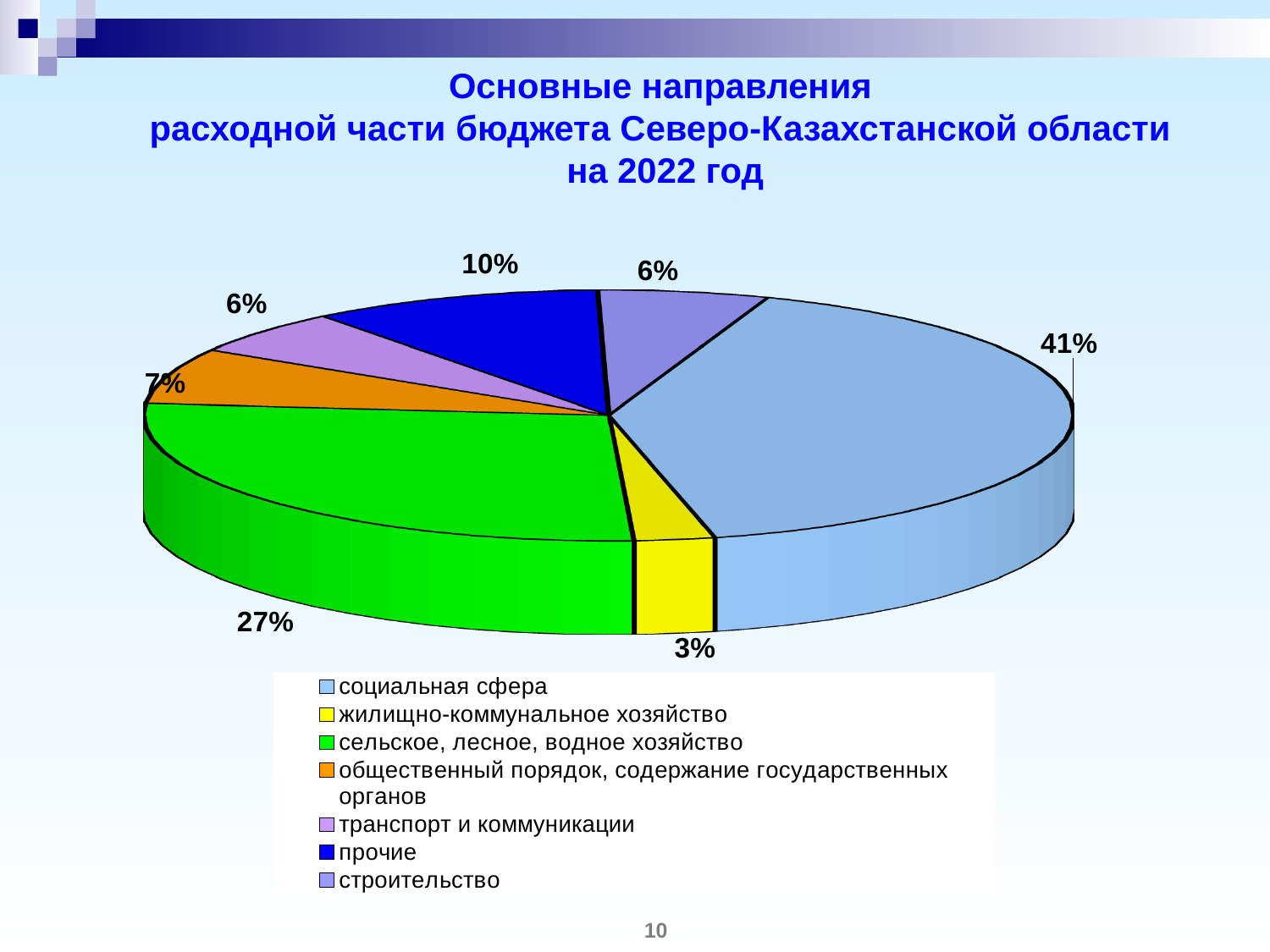
What share of the budget expenditure goes to прочие? 10% What share of the budget expenditure goes to жилищно-коммунальное хозяйство? 3% What share of the budget expenditure goes to общественный порядок, содержание государственных органов? 7% Which category has the smallest share of the pie? жилищно-коммунальное хозяйство What year does the chart title refer to? 2022 What share of the budget expenditure goes to сельское, лесное, водное хозяйство? 27% What is the difference in percentage points between социальная сфера and сельское, лесное, водное хозяйство? 14 Which category has the largest share of the pie? социальная сфера What share of the budget expenditure goes to социальная сфера? 41% Which is larger: the share for прочие or the share for транспорт и коммуникации? прочие How many categories does the legend list? 7 What kind of chart is shown on the slide? pie chart